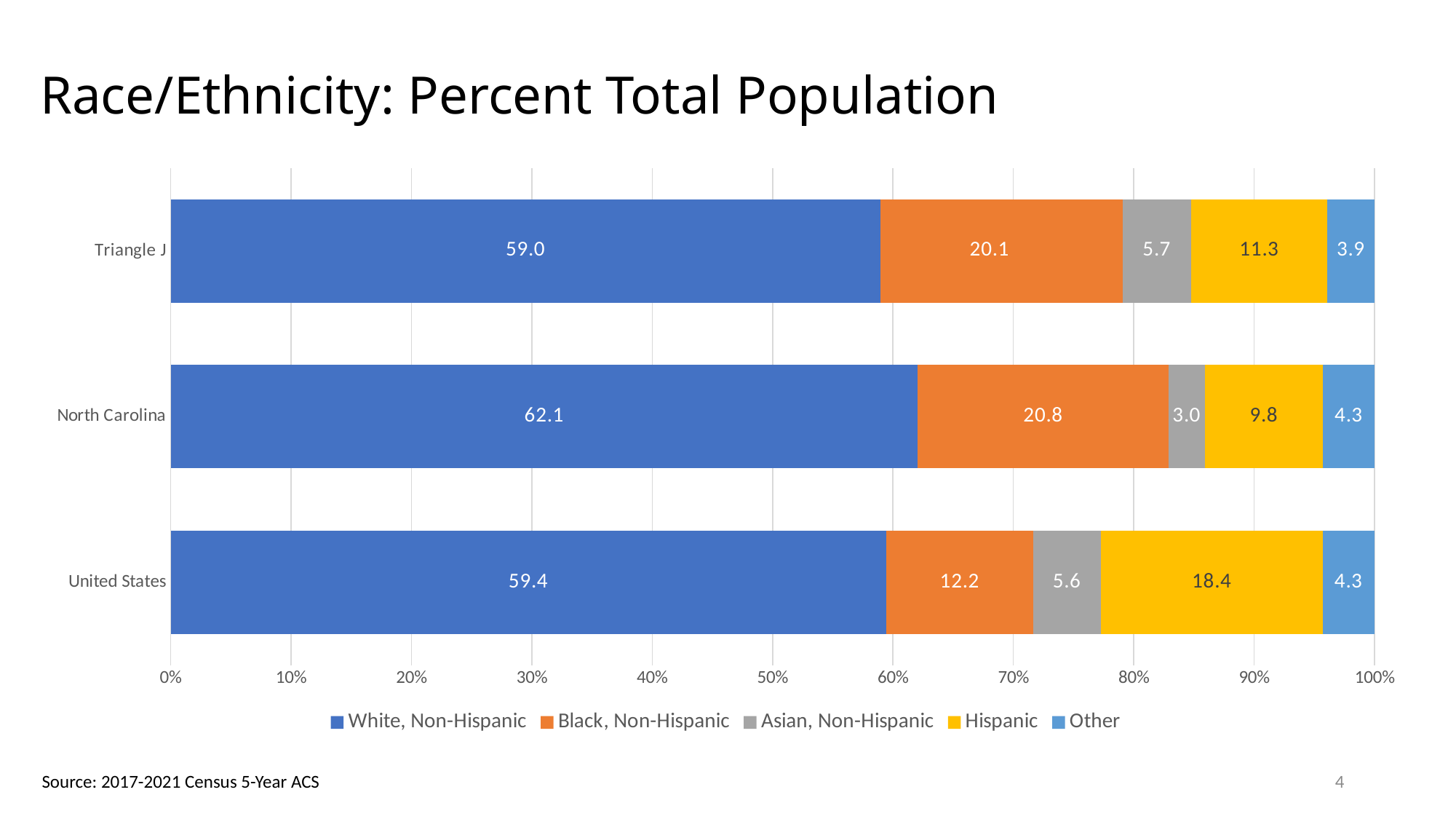
What is the total of the Black, Non-Hispanic and Asian, Non-Hispanic percentages for Triangle J? 25.8 Which region has the highest Black, Non-Hispanic percentage? North Carolina What is the White, Non-Hispanic percentage for Triangle J? 59.0 Which is larger, the White, Non-Hispanic percentage for North Carolina or for the United States? North Carolina What is the difference between the Hispanic percentage for the United States and for Triangle J? 7.1 How many regions are shown on the chart? 3 How many series does the legend list? 5 What is the Asian, Non-Hispanic percentage for North Carolina? 3.0 What is the title of the chart? Race/Ethnicity: Percent Total Population What is the Hispanic percentage for the United States? 18.4 Which region has the lowest Hispanic percentage? North Carolina What kind of chart is shown on the slide? Stacked bar chart